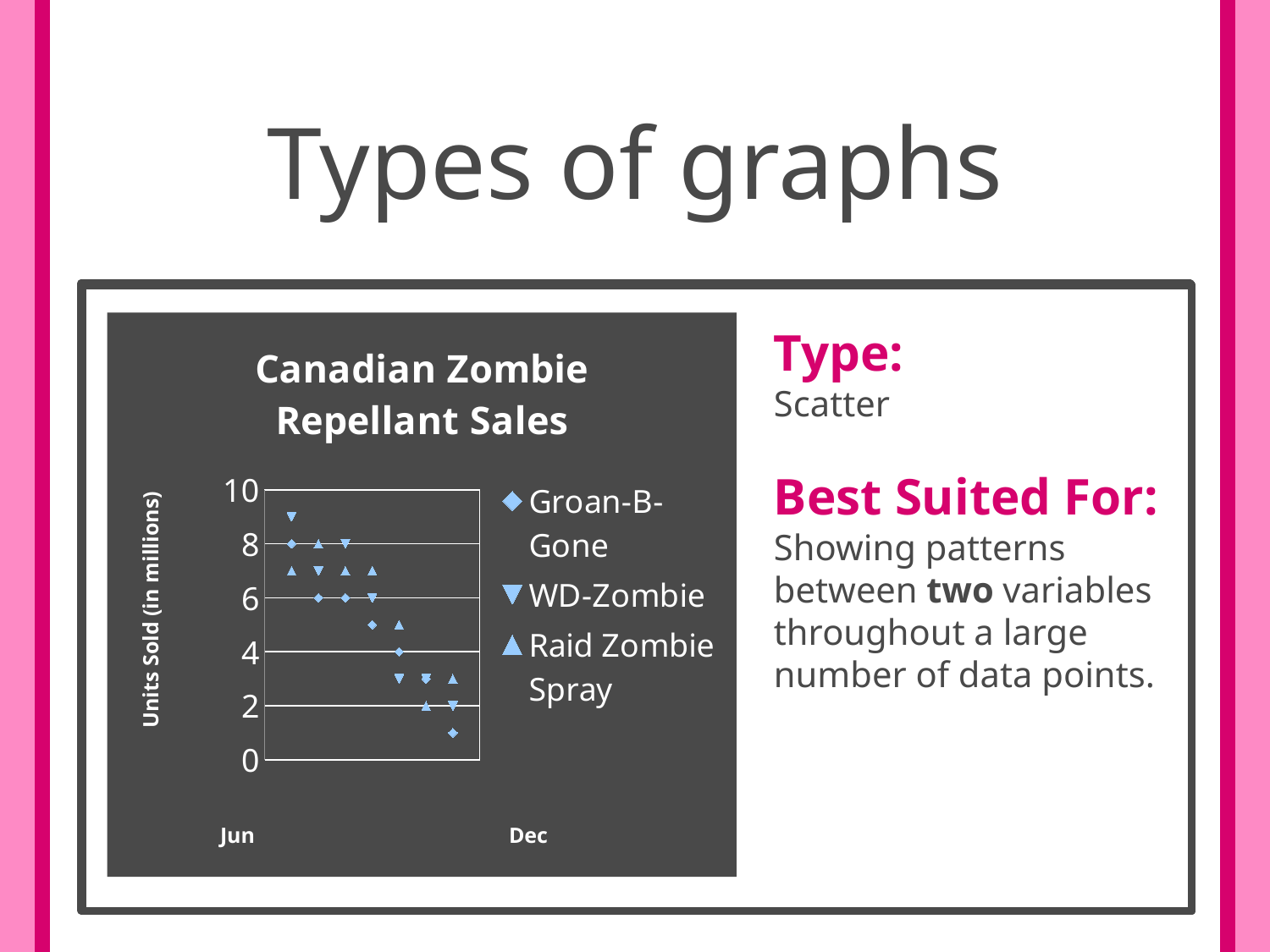
Is the highest WD-Zombie point near Jun greater or less than 8? greater Is the lowest Groan-B-Gone point near Dec greater or less than 2? less How many series does the legend of the Canadian Zombie Repellant Sales chart list? 3 Do the plotted values in the chart generally rise or fall from Jun to Dec? fall Which series in the chart is marked with diamond markers? Groan-B-Gone What is the title of the chart on the slide? Canadian Zombie Repellant Sales What kind of chart is shown on the slide? scatter chart